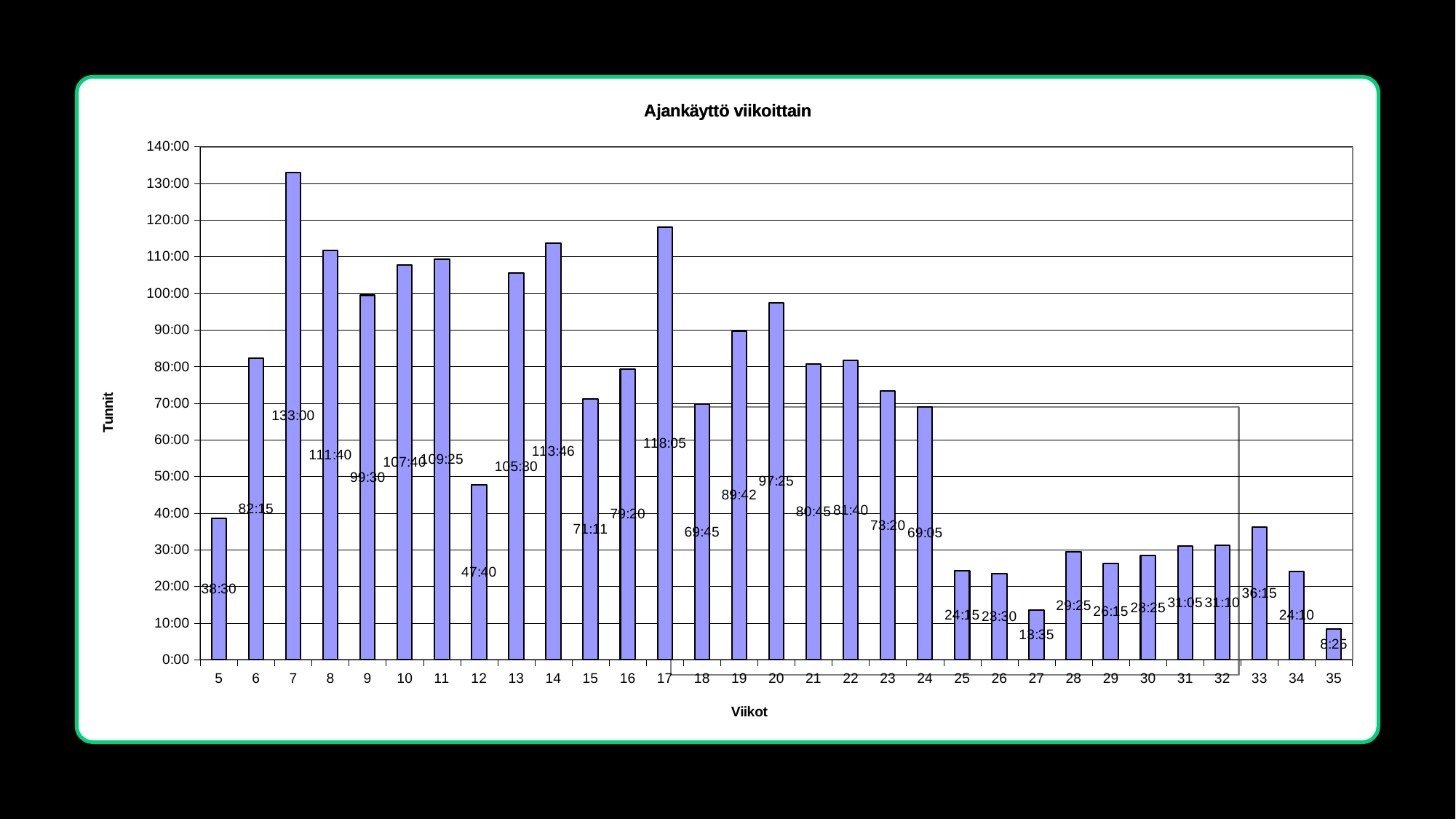
Which week has the larger value, week 13 or week 14? 14 What is the label of the vertical axis? Tunnit Is the value for week 17 greater or less than 110:00? greater What is the title of the chart? Ajankäyttö viikoittain What is the value for week 7? 133:00 What is the difference between the values for week 7 and week 17? 14:55 What is the value for week 12? 47:40 Which week has the highest value? 7 What is the value for week 27? 13:35 How many weeks are plotted on the chart? 31 Which week has the lowest value? 35 What type of chart is shown on the slide? bar chart